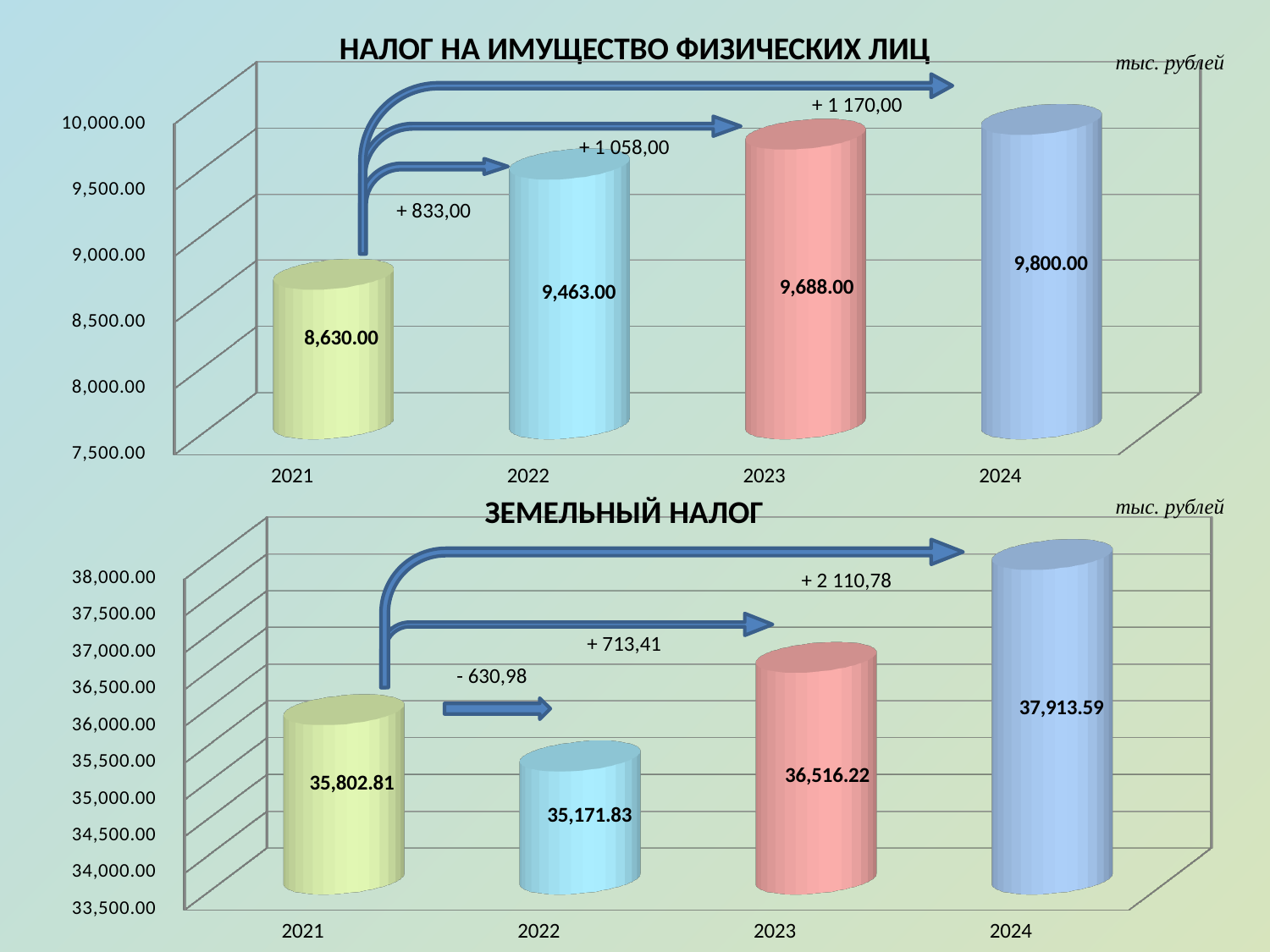
In the chart titled "НАЛОГ НА ИМУЩЕСТВО ФИЗИЧЕСКИХ ЛИЦ", what is the difference between the values for 2022 and 2021? 833.00 In the chart titled "ЗЕМЕЛЬНЫЙ НАЛОГ", what is the value for 2024? 37,913.59 In the chart titled "ЗЕМЕЛЬНЫЙ НАЛОГ", what is the difference between the values for 2024 and 2023? 1,397.37 What kind of chart is the chart titled "ЗЕМЕЛЬНЫЙ НАЛОГ"? bar chart In the chart titled "НАЛОГ НА ИМУЩЕСТВО ФИЗИЧЕСКИХ ЛИЦ", what is the value for 2023? 9,688.00 In the chart titled "ЗЕМЕЛЬНЫЙ НАЛОГ", which year has the lowest value? 2022 In the chart titled "ЗЕМЕЛЬНЫЙ НАЛОГ", what is the value for 2022? 35,171.83 In the chart titled "НАЛОГ НА ИМУЩЕСТВО ФИЗИЧЕСКИХ ЛИЦ", what is the value for 2021? 8,630.00 In the chart titled "НАЛОГ НА ИМУЩЕСТВО ФИЗИЧЕСКИХ ЛИЦ", how many years are shown on the x axis? 4 In the chart titled "НАЛОГ НА ИМУЩЕСТВО ФИЗИЧЕСКИХ ЛИЦ", which year has the highest value? 2024 In the chart titled "ЗЕМЕЛЬНЫЙ НАЛОГ", which is larger, the value for 2021 or the value for 2023? 2023 In the chart titled "НАЛОГ НА ИМУЩЕСТВО ФИЗИЧЕСКИХ ЛИЦ", do the values rise or fall from 2021 to 2024? rise